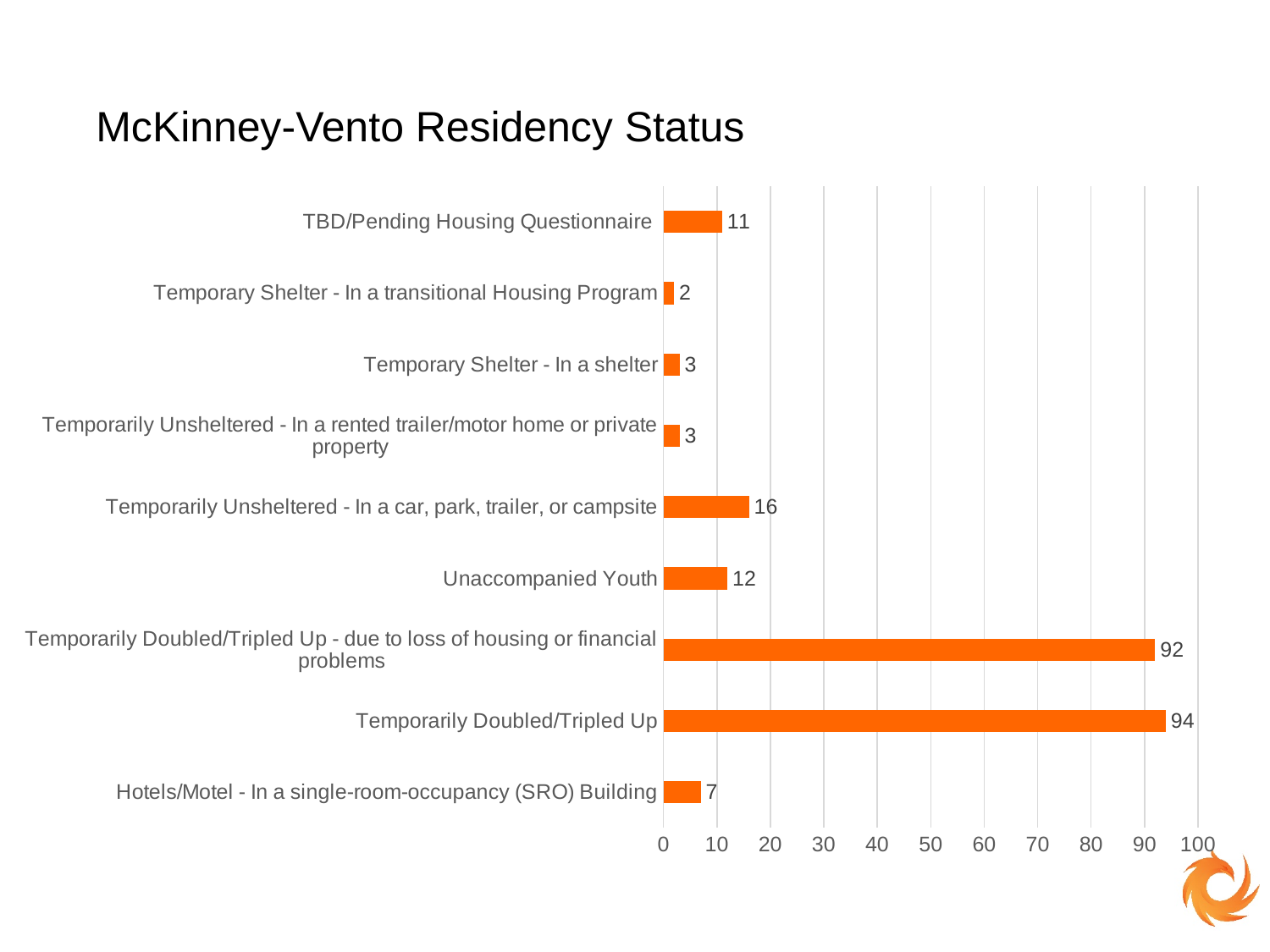
Which category has the highest value? Temporarily Doubled/Tripled Up Is the value for Temporarily Doubled/Tripled Up - due to loss of housing or financial problems greater or less than 90? greater What kind of chart is this? bar chart What is the value for Unaccompanied Youth? 12 How many categories are shown in the chart? 9 What is the value for Hotels/Motel - In a single-room-occupancy (SRO) Building? 7 What is the value for Temporarily Unsheltered - In a car, park, trailer, or campsite? 16 Which is larger, TBD/Pending Housing Questionnaire or Unaccompanied Youth? Unaccompanied Youth What is the value for Temporarily Doubled/Tripled Up? 94 Which category has the lowest value? Temporary Shelter - In a transitional Housing Program What is the difference between Temporarily Doubled/Tripled Up and Temporarily Doubled/Tripled Up - due to loss of housing or financial problems? 2 What is the title of the chart? McKinney-Vento Residency Status